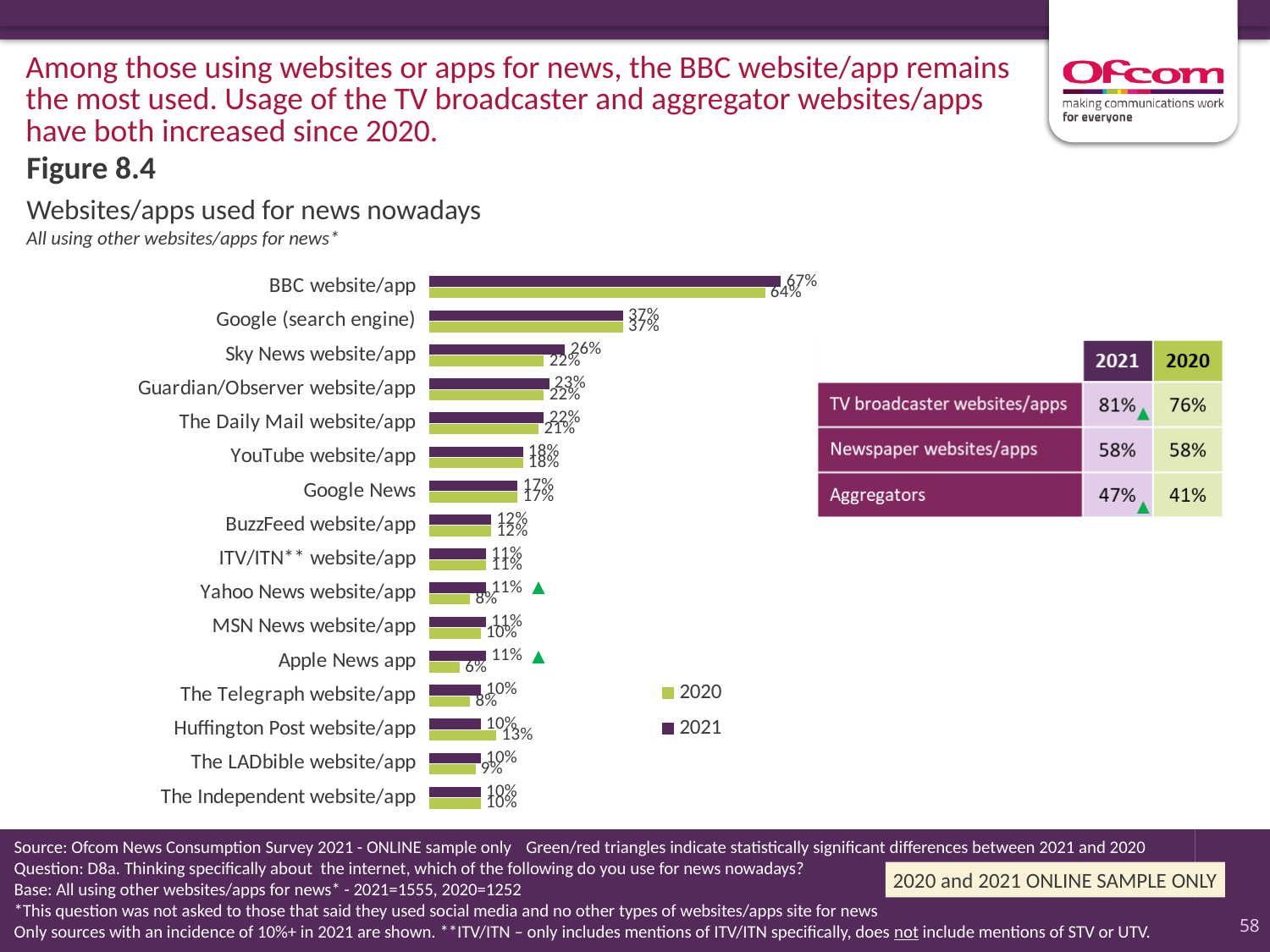
What is the 2020 value for Apple News app? 6% Which is larger for Huffington Post website/app, the 2021 value or the 2020 value? 2020 What type of chart is shown on the slide? bar chart What is the 2020 value for BBC website/app? 64% How many series does the chart legend list? 2 In the table, what is the 2021 value for TV broadcaster websites/apps? 81% In the table, what is the 2020 value for Aggregators? 41% What is the difference between the 2021 and 2020 values for Sky News website/app? 4% Which website/app has the highest 2021 value? BBC website/app What is the 2021 value for BBC website/app? 67% How many websites/apps are listed as categories in the bar chart? 16 What is the 2021 value for Sky News website/app? 26%